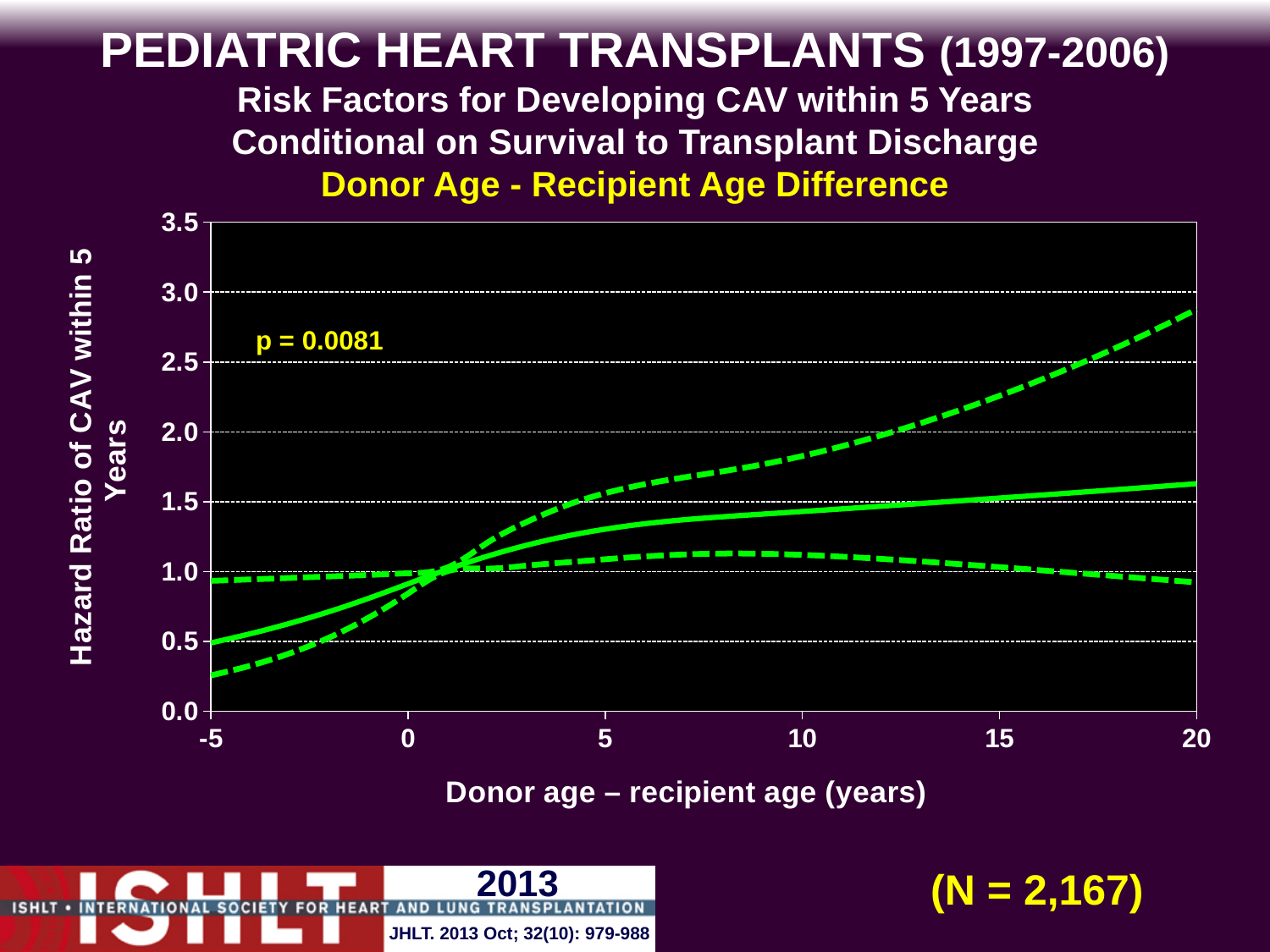
Is the value of the upper dashed line at a donor-recipient age difference of 20 years greater or less than 3.0? less Is the value of the lower dashed line at a donor-recipient age difference of 20 years greater or less than 1.0? less Is the value of the upper dashed line at a donor-recipient age difference of 20 years greater or less than 2.5? greater What p-value is shown on the chart? p = 0.0081 Does the solid line rise or fall as donor age minus recipient age increases from -5 to 20 years? rise What is the sample size (N) shown on the slide? N = 2,167 How many lines are plotted on the chart? 3 What kind of chart is shown on the slide? line chart